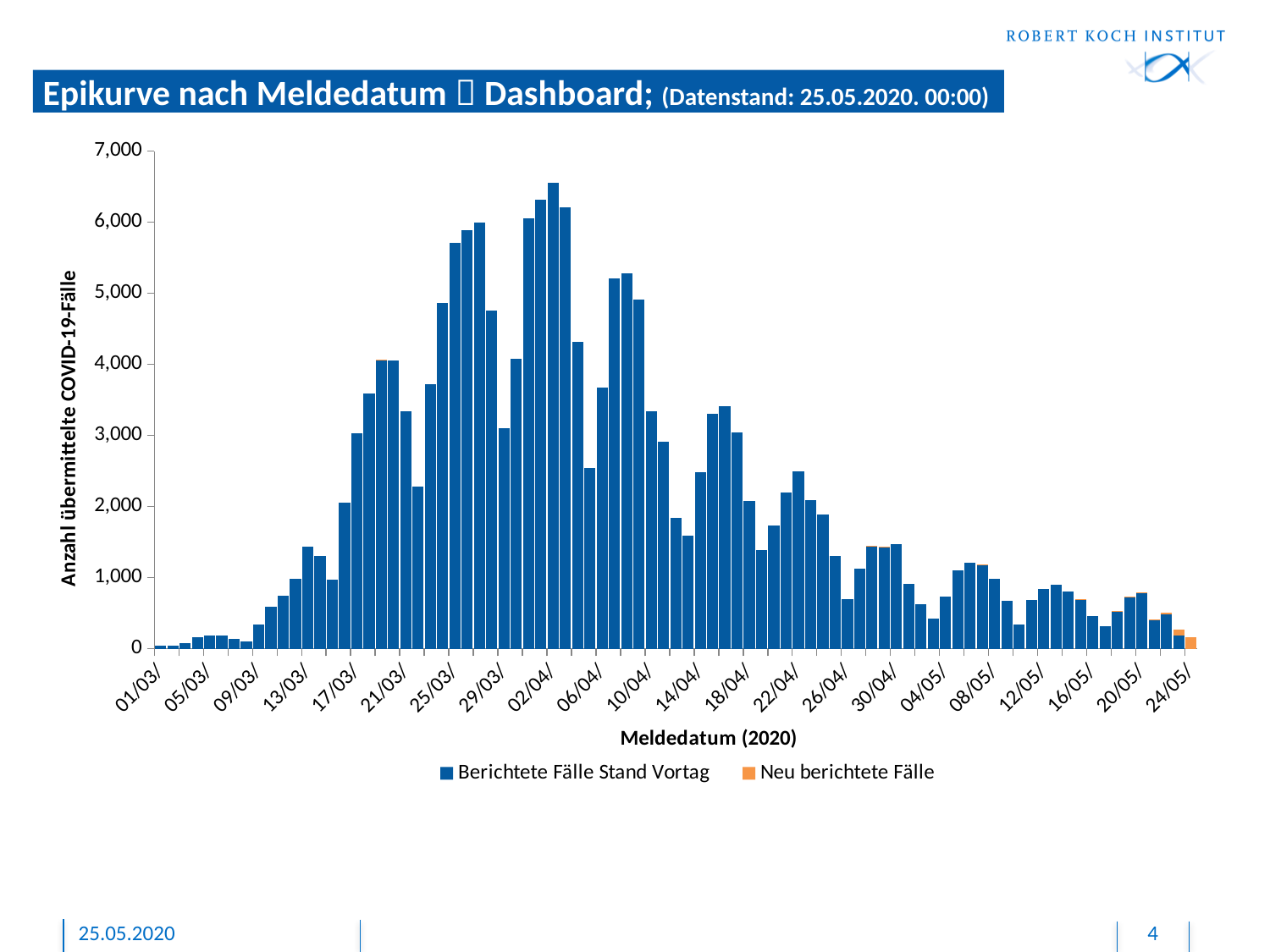
Is the value for 25/03/ greater or less than 5,000? greater What are the two series named in the legend? Berichtete Fälle Stand Vortag; Neu berichtete Fälle Which labelled date on the x axis has the highest bar? 02/04/ Is the value for 24/05/ greater or less than 1,000? less Is the value for 26/04/ greater or less than 1,000? less Do the values generally rise or fall along the x axis from 02/04/ to 24/05/? fall Which is larger, the value for 25/03/ or the value for 12/05/? 25/03/ What is the title of the y axis? Anzahl übermittelte COVID-19-Fälle What kind of chart is shown on the slide? bar chart How many series does the legend list? 2